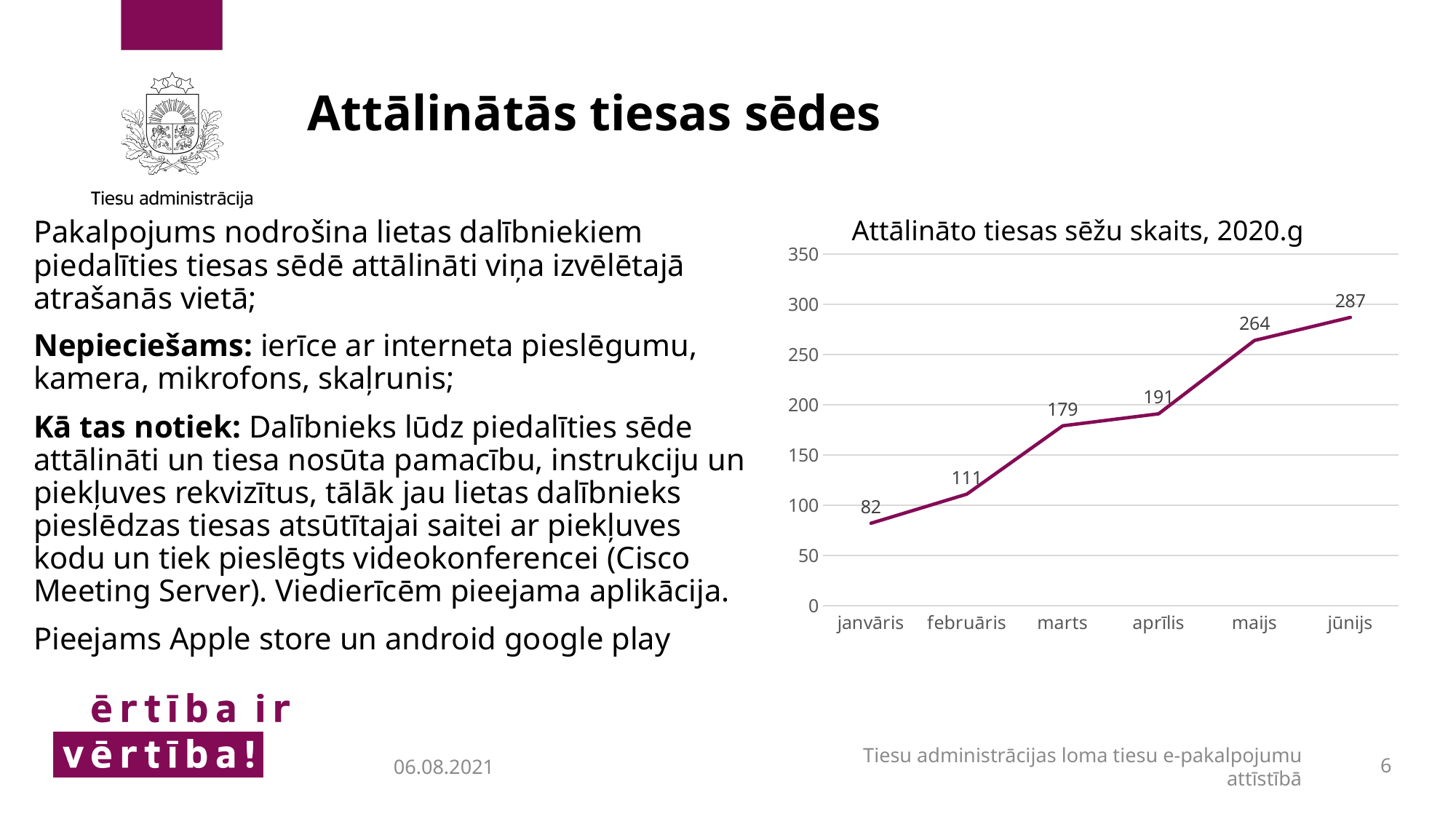
Which is larger, the value for februāris or the value for marts? marts Which month has the lowest value? janvāris What is the difference between the values for maijs and aprīlis? 73 What is the value for marts? 179 What is the value for janvāris? 82 How many months are plotted on the chart? 6 Do the values rise or fall from janvāris to jūnijs? rise Which month has the highest value? jūnijs What is the value for jūnijs? 287 Is the value for maijs greater or less than 250? greater What kind of chart is shown on the slide? line chart What is the difference between the values for jūnijs and janvāris? 205